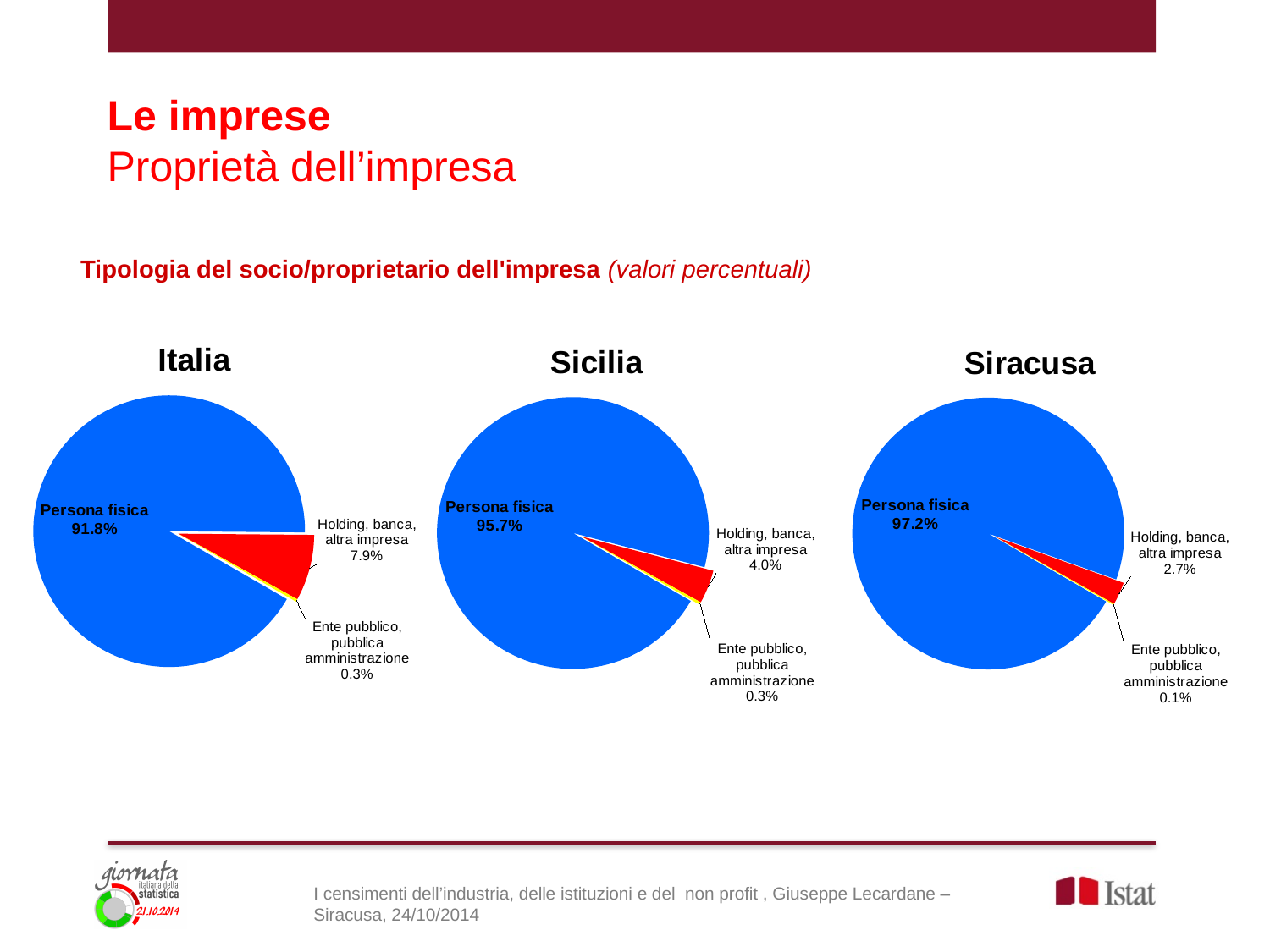
How many slices does the Sicilia pie chart have? 3 Which is larger: the Holding, banca, altra impresa share in the Italia chart or in the Siracusa chart? Italia In the Italia chart, which category has the largest slice? Persona fisica In the Sicilia chart, what is the value for Holding, banca, altra impresa? 4.0% In the Italia chart, what is the difference between Holding, banca, altra impresa and Ente pubblico, pubblica amministrazione? 7.6% How many pie charts are shown on the slide? 3 In the Sicilia chart, which category has the smallest slice? Ente pubblico, pubblica amministrazione In the Italia chart, what is the value for Persona fisica? 91.8% In the Siracusa chart, what is the value for Persona fisica? 97.2% What colour is the Persona fisica slice in the Italia chart? Blue What kind of chart is used for Siracusa? Pie chart In the Siracusa chart, what is the value for Ente pubblico, pubblica amministrazione? 0.1%